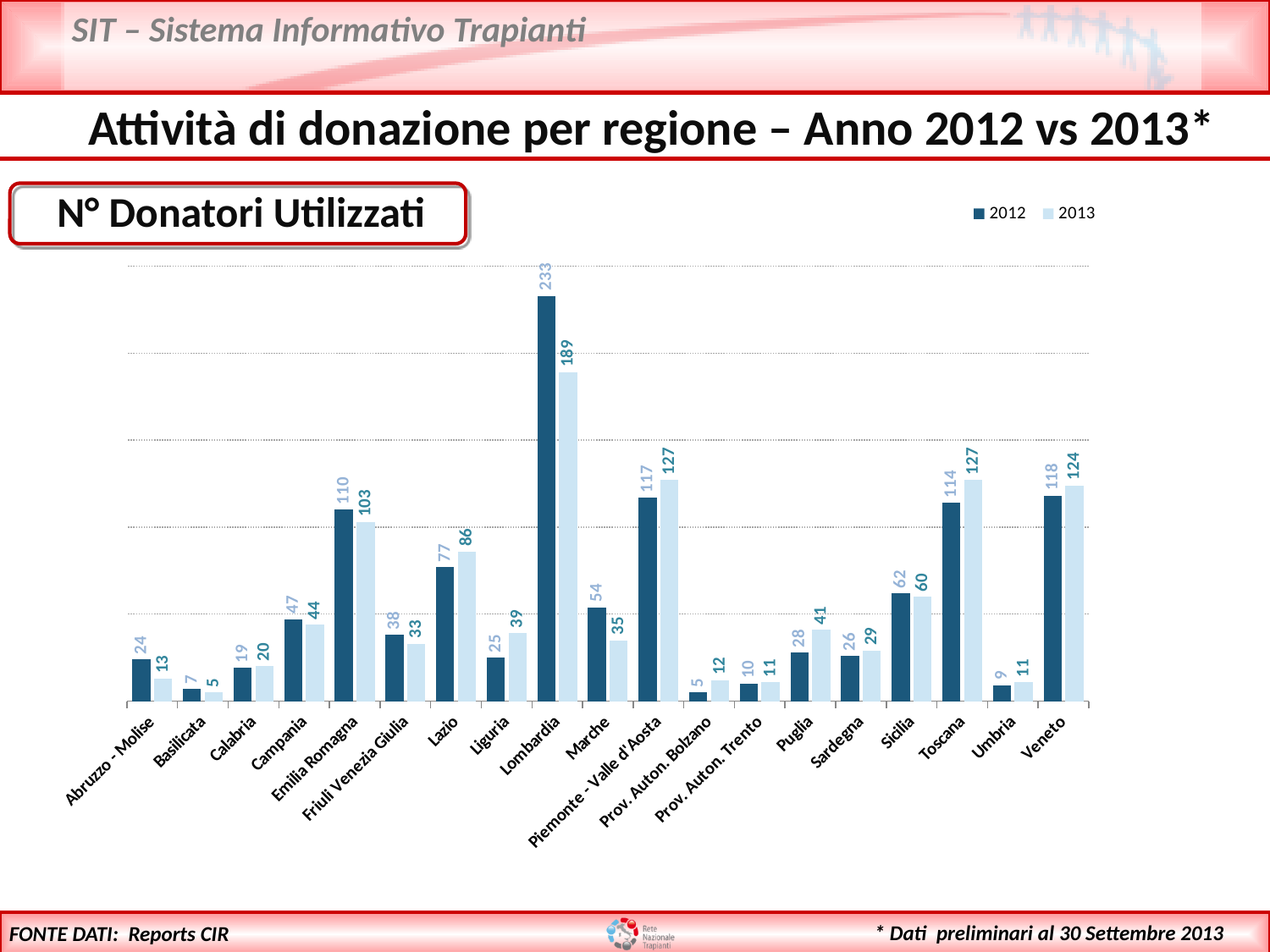
What is the 2013 value for Lazio? 86 What is the 2013 value for Toscana? 127 What kind of chart is shown? Bar chart Which region has the lowest 2012 value? Prov. Auton. Bolzano How many regions are shown on the x axis? 19 What is the title of the chart? N° Donatori Utilizzati How many series does the legend list? 2 Which region has the highest 2013 value? Lombardia What is the difference between the 2012 and 2013 values for Lombardia? 44 What is the 2012 value for Lombardia? 233 Which is larger for Marche, the 2012 value or the 2013 value? 2012 What is the total of the 2012 and 2013 values for Veneto? 242